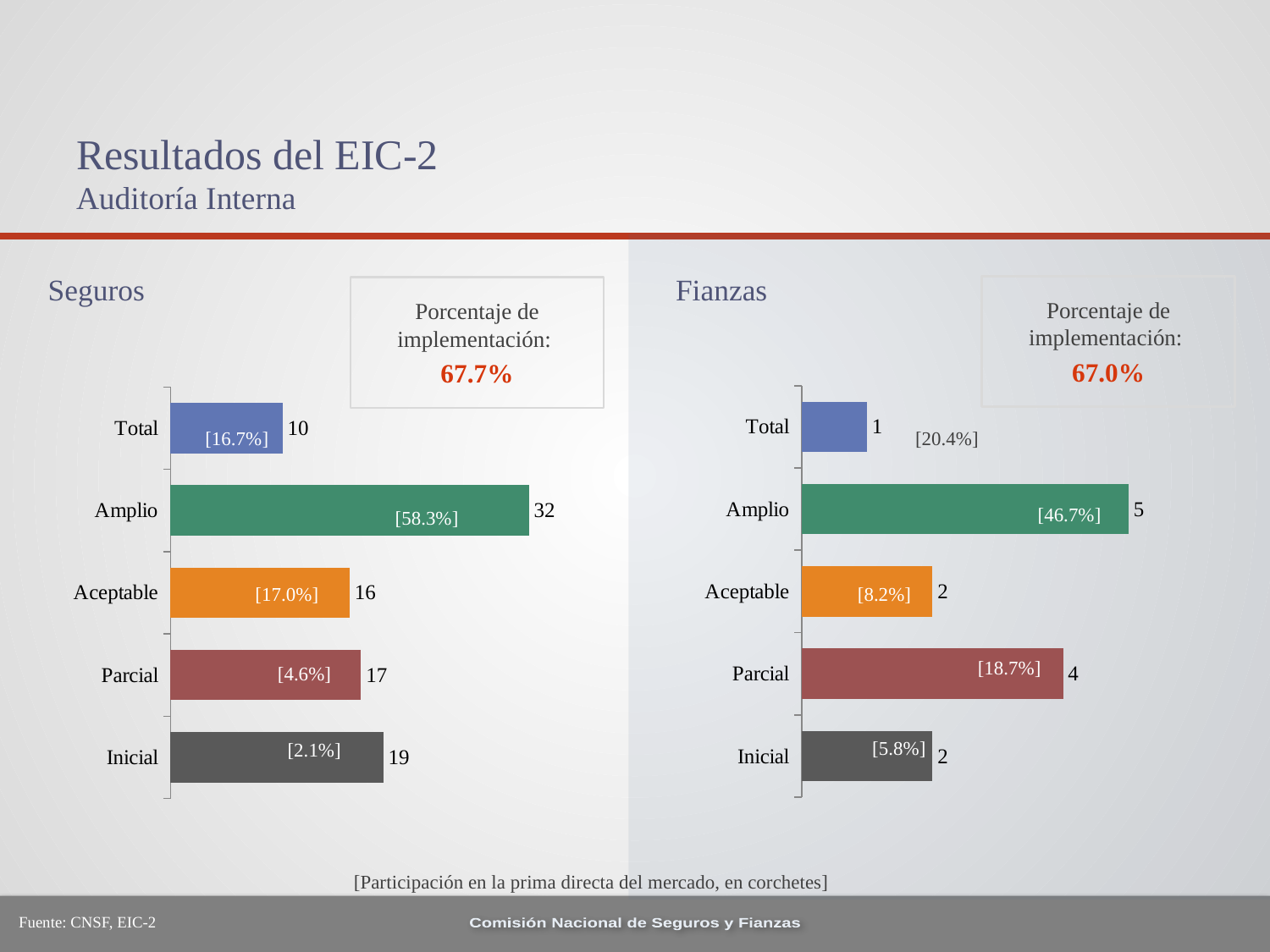
In the Seguros chart, which category has the highest value? Amplio In the Fianzas chart, which is larger, the value for Parcial or the value for Aceptable? Parcial In the Seguros chart, what is the value for Amplio? 32 What kind of chart is the Seguros chart? Bar chart In the Seguros chart, what is the value for Inicial? 19 How many categories does the Fianzas chart show? 5 In the Seguros chart, which category has the lowest value? Total In the Seguros chart, what is the difference between the values for Amplio and Inicial? 13 In the Seguros chart, what bracketed market share is shown for Amplio? [58.3%] In the Fianzas chart, which category has the highest value? Amplio In the Fianzas chart, what is the value for Total? 1 In the Fianzas chart, what is the value for Parcial? 4